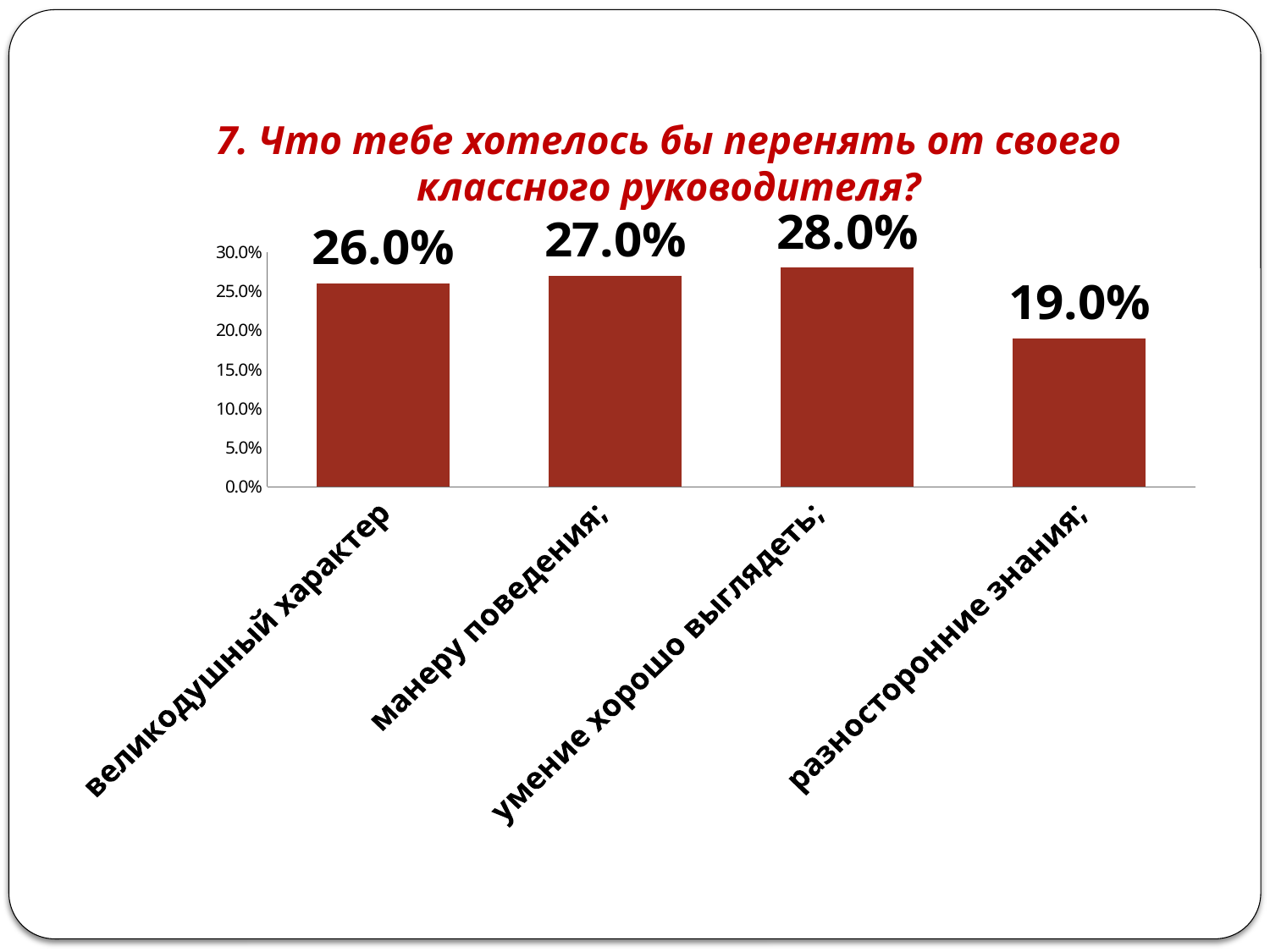
What is the value for "манеру поведения"? 27.0% What kind of chart is shown on the slide? bar chart What is the value for "разносторонние знания"? 19.0% What is the value for "великодушный характер"? 26.0% Which category has the lowest value? разносторонние знания Which category has the highest value? умение хорошо выглядеть What is the title of the chart? 7. Что тебе хотелось бы перенять от своего классного руководителя? How many categories are shown in the chart? 4 Is the value for "разносторонние знания" greater or less than 20.0%? less Which is larger: the value for "великодушный характер" or the value for "разносторонние знания"? великодушный характер What is the value for "умение хорошо выглядеть"? 28.0% What is the difference between the values for "умение хорошо выглядеть" and "разносторонние знания"? 9.0%